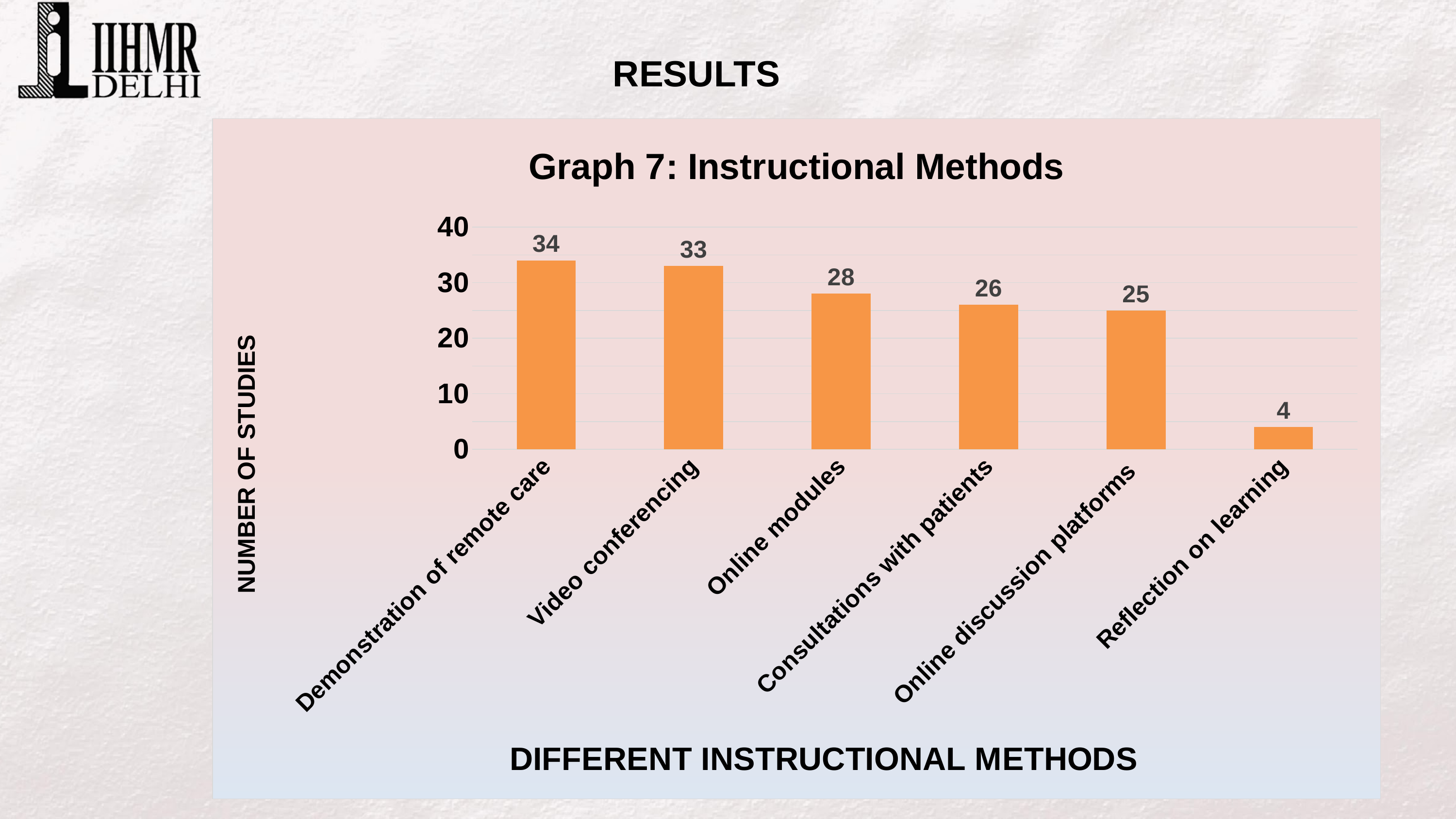
What is the title of the chart? Graph 7: Instructional Methods Which instructional method has the highest number of studies? Demonstration of remote care What is the number of studies for Reflection on learning? 4 What kind of chart is shown on the slide? Bar chart What is the difference in number of studies between Demonstration of remote care and Online modules? 6 What is the number of studies for Video conferencing? 33 What is the difference in number of studies between Consultations with patients and Reflection on learning? 22 How many instructional methods are shown on the chart? 6 What is the number of studies for Online discussion platforms? 25 Is the value for Consultations with patients greater or less than 20? greater Which has more studies, Online modules or Online discussion platforms? Online modules Which instructional method has the lowest number of studies? Reflection on learning